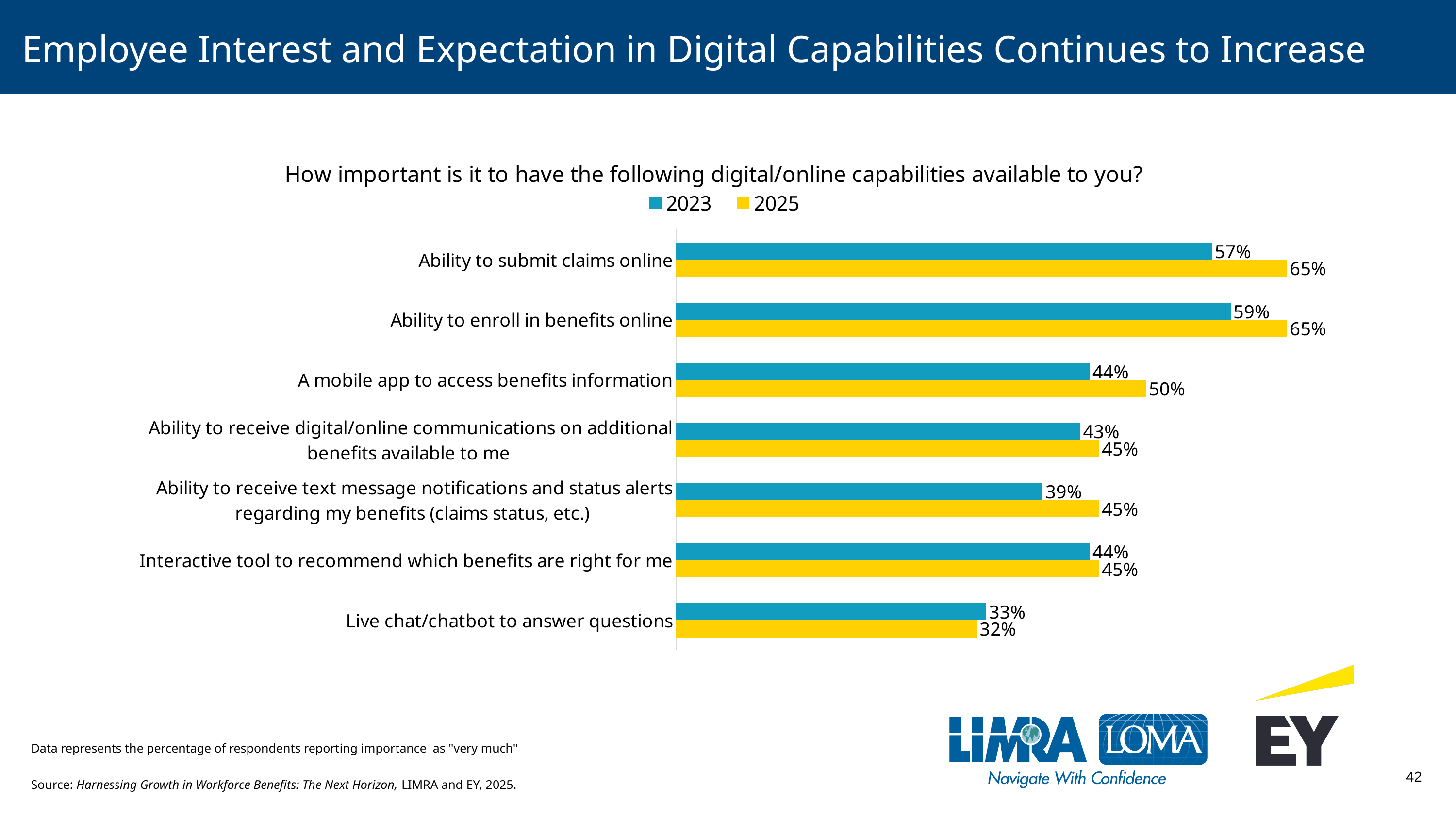
What was the 2023 value for 'Live chat/chatbot to answer questions'? 33% How many series does the legend list? 2 What was the 2025 value for 'Ability to submit claims online'? 65% Which capability had the highest 2023 value? Ability to enroll in benefits online What was the 2023 value for 'Ability to enroll in benefits online'? 59% For 'Live chat/chatbot to answer questions', which year had the larger value, 2023 or 2025? 2023 What is the difference between the 2023 and 2025 values for 'Ability to receive text message notifications and status alerts regarding my benefits (claims status, etc.)'? 6 percentage points What type of chart is shown on the slide? Bar chart How many capabilities are listed in the chart? 7 What was the 2025 value for 'A mobile app to access benefits information'? 50% Which capability had the lowest 2025 value? Live chat/chatbot to answer questions By how many percentage points did 'Ability to submit claims online' increase from 2023 to 2025? 8 percentage points